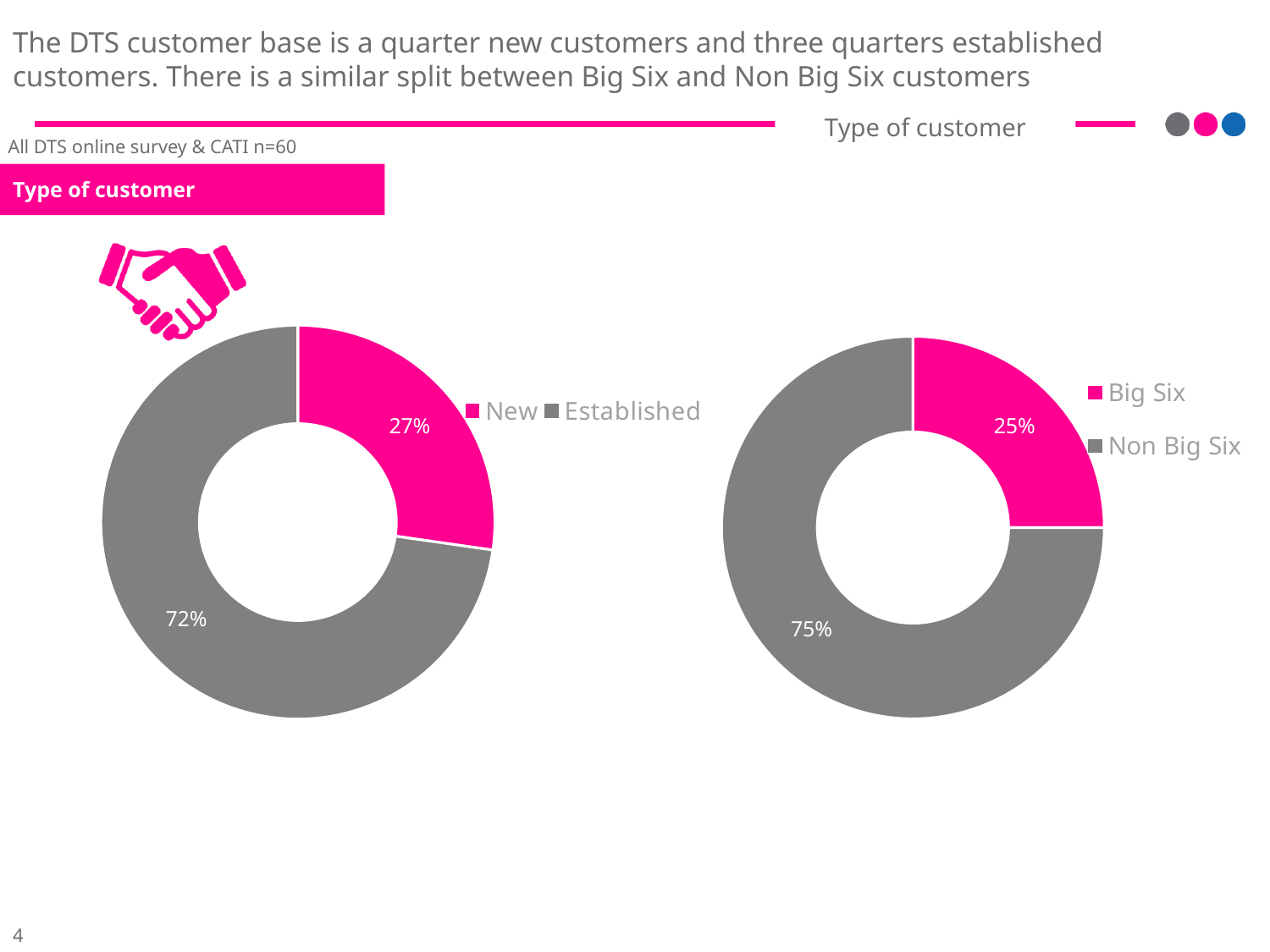
In the right chart (Big Six vs Non Big Six), what percentage of customers are Big Six? 25% In the left chart (New vs Established), what percentage of customers are New? 27% In the right chart (Big Six vs Non Big Six), which category has the smaller share? Big Six In the right chart (Big Six vs Non Big Six), what percentage of customers are Non Big Six? 75% In the right chart (Big Six vs Non Big Six), what is the difference in percentage points between Non Big Six and Big Six? 50 Is the New share in the left chart larger or smaller than the Big Six share in the right chart? larger In the left chart (New vs Established), what is the difference in percentage points between Established and New? 45 How many categories does the legend of the right chart (Big Six vs Non Big Six) list? 2 In the left chart (New vs Established), which category has the larger share? Established What kind of chart is used on this slide? Doughnut (pie) chart In the left chart, which colour represents the New category? Pink In the left chart (New vs Established), what percentage of customers are Established? 72%